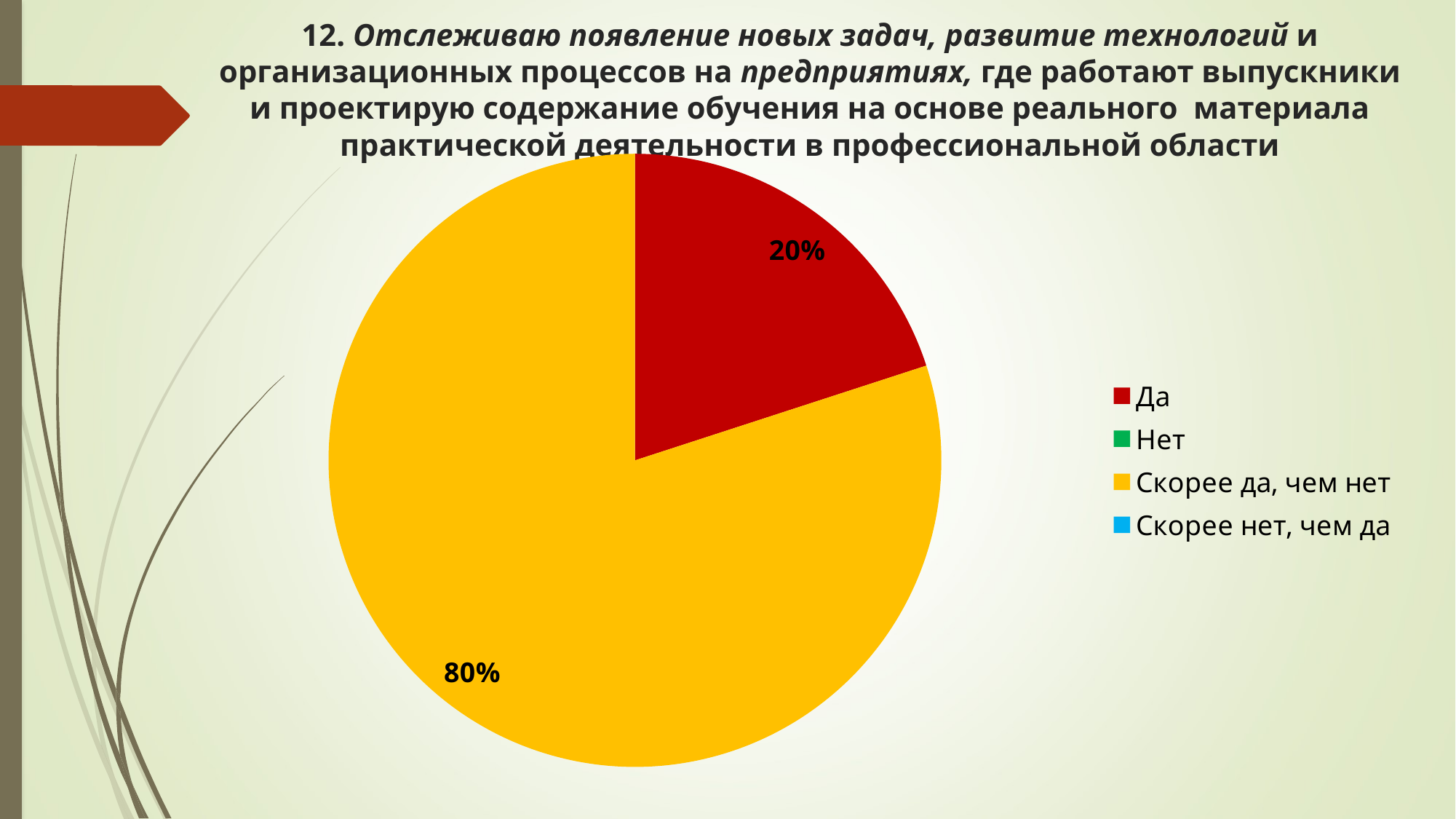
What share of the pie does "Да" have? 20% What share of the pie does "Скорее да, чем нет" have? 80% What colour is the slice for "Да"? red Which of the two visible slices is smaller, "Да" or "Скорее да, чем нет"? Да Which is larger, the share for "Да" or the share for "Скорее да, чем нет"? Скорее да, чем нет Which category has the largest slice of the pie? Скорее да, чем нет How many entries does the legend list? 4 What is the difference between the shares of "Скорее да, чем нет" and "Да"? 60% What kind of chart is shown on the slide? pie chart Is the share for "Скорее да, чем нет" greater or less than 50%? greater What colour is the slice for "Скорее да, чем нет"? yellow How many slices with a visible share are shown in the pie? 2